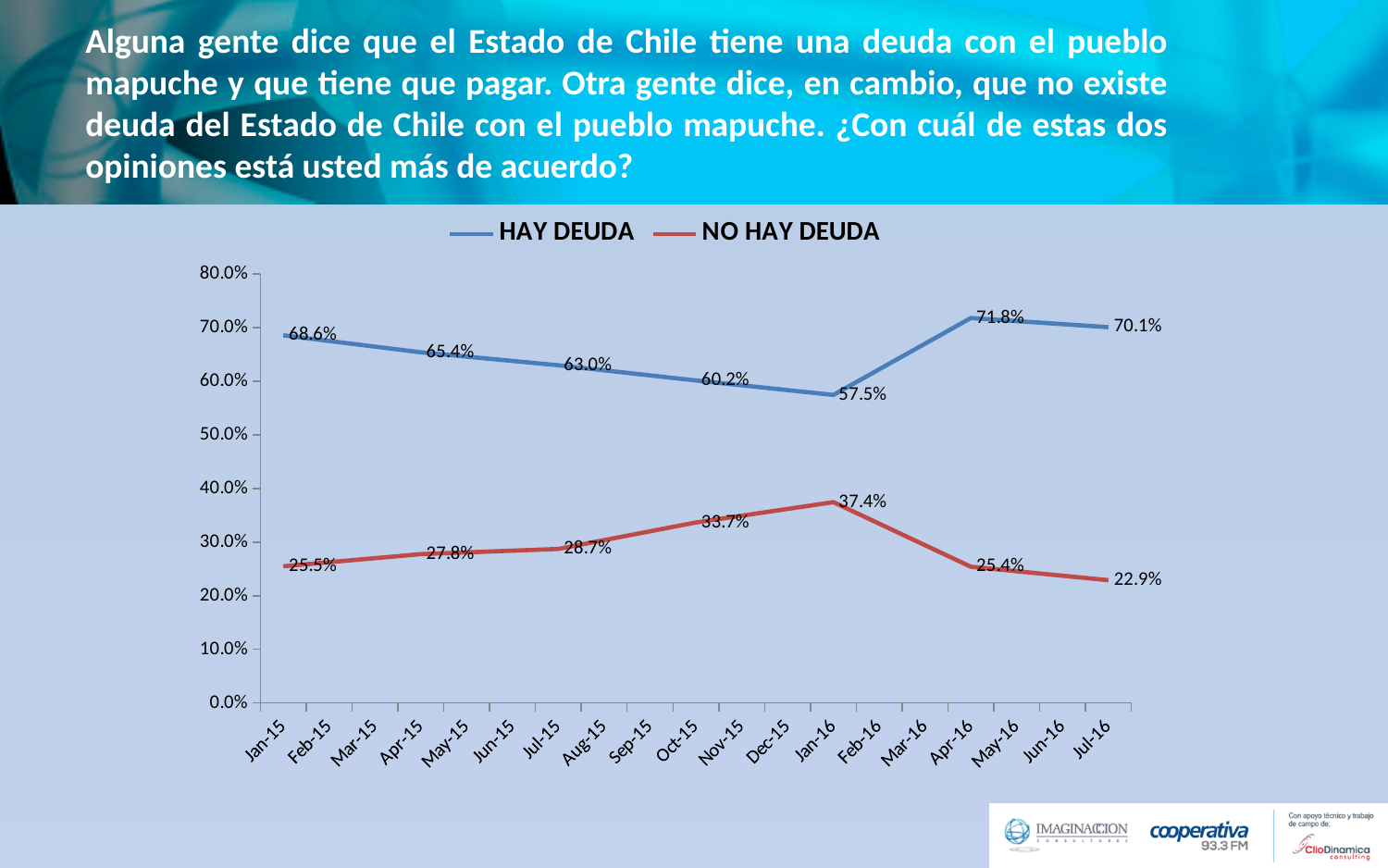
In which month does the NO HAY DEUDA series reach its highest value? Jan-16 Which series has the larger value in Jan-15, HAY DEUDA or NO HAY DEUDA? HAY DEUDA What is the difference between HAY DEUDA and NO HAY DEUDA in Jul-16? 47.2% Which colour is used for the NO HAY DEUDA line? red How many series does the legend list? 2 How many data points are labelled on the HAY DEUDA line? 7 What is the value for NO HAY DEUDA in Oct-15? 33.7% In which month does the HAY DEUDA series reach its lowest value? Jan-16 What is the value for HAY DEUDA in Apr-16? 71.8% What is the value for HAY DEUDA in Jan-16? 57.5% What kind of chart is shown on the slide? line chart Does the HAY DEUDA series rise or fall from Jan-15 to Jan-16? fall